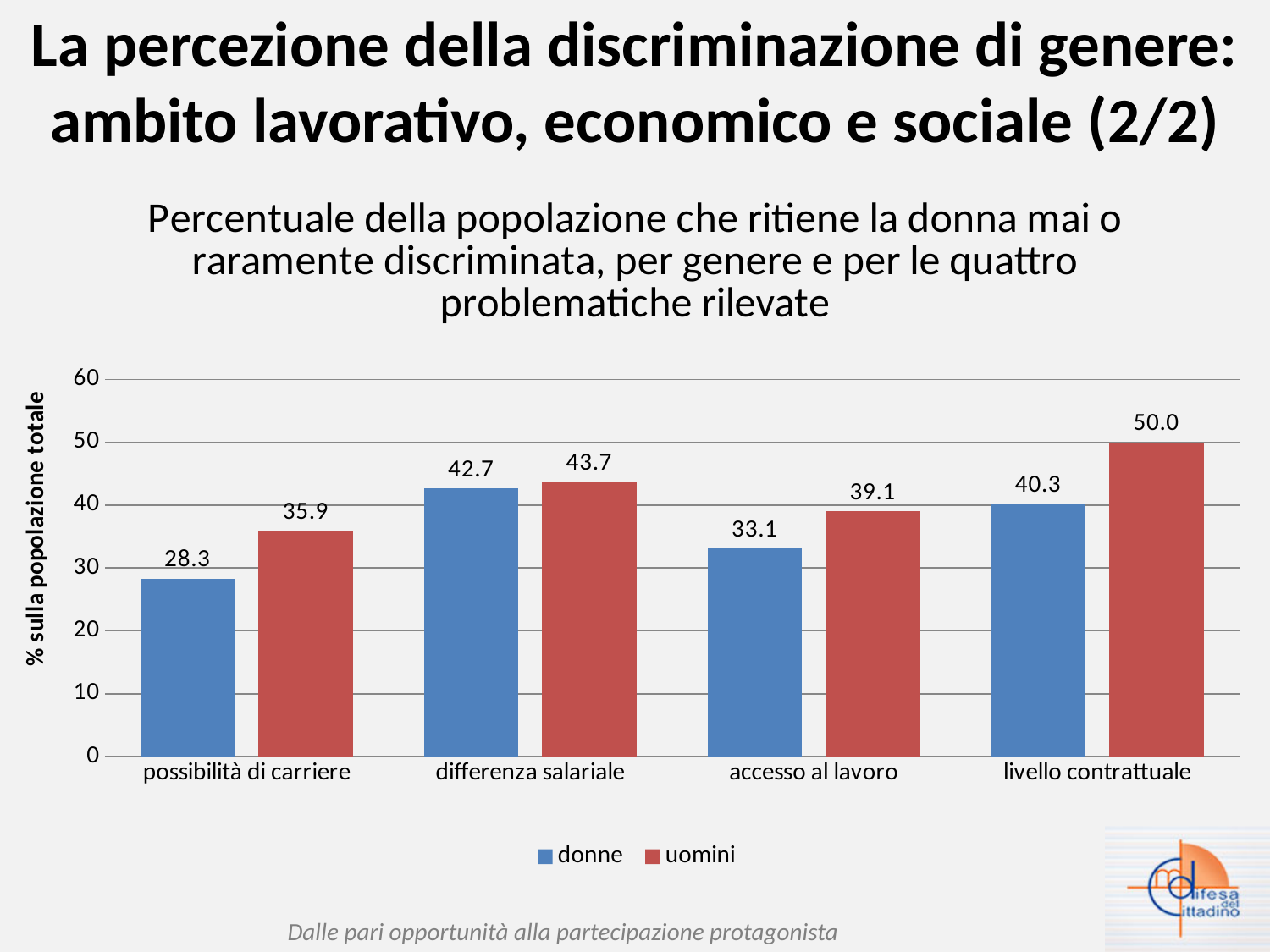
What is the difference between the uomini and donne values for livello contrattuale? 9.7 How many categories are shown on the x axis? 4 Which is larger in the accesso al lavoro category, the donne value or the uomini value? uomini What is the value for uomini in the livello contrattuale category? 50.0 Which category has the highest value for uomini? livello contrattuale What is the value for donne in the possibilità di carriere category? 28.3 Which category has the lowest value for donne? possibilità di carriere How many series does the legend list? 2 What is the value for uomini in the accesso al lavoro category? 39.1 What kind of chart is shown on the slide? bar chart What is the label of the y axis? % sulla popolazione totale Is the value for donne in the differenza salariale category greater or less than 40? greater